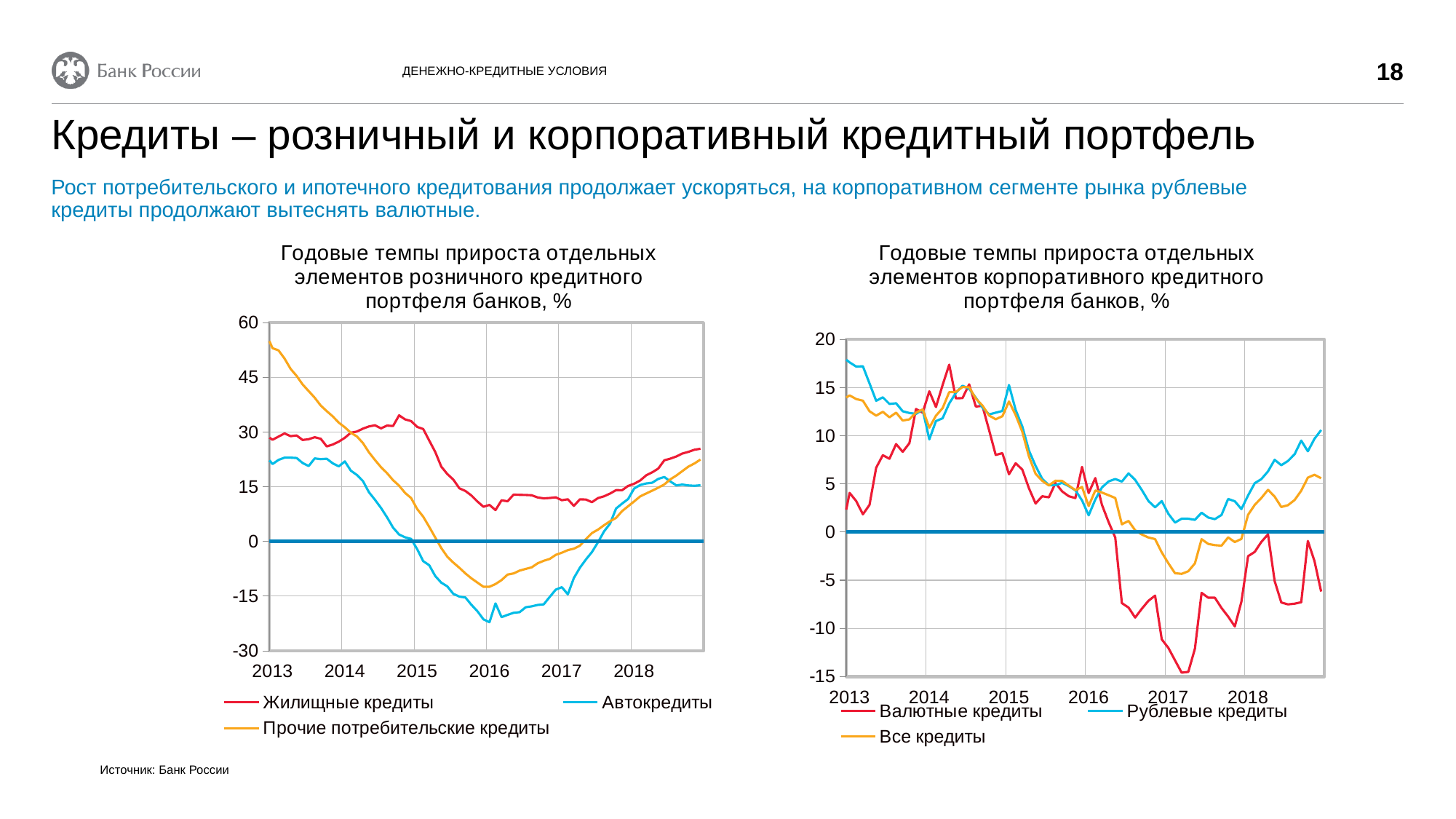
In the right chart (corporate loan portfolio), is the value for 'Рублевые кредиты' at the start of 2013 greater or less than 15? greater In the left chart (retail loan portfolio), is the value for 'Прочие потребительские кредиты' at the start of 2013 greater or less than 45? greater In the right chart (corporate loan portfolio), does the 'Рублевые кредиты' line rise or fall between 2017 and the end of 2018? rise In the right chart (corporate loan portfolio), which series has the higher value at the start of 2017: 'Валютные кредиты' or 'Рублевые кредиты'? Рублевые кредиты How many series does the legend of the left chart (retail loan portfolio) list? 3 How many series does the legend of the right chart, 'Годовые темпы прироста отдельных элементов корпоративного кредитного портфеля банков, %', list? 3 In the left chart (retail loan portfolio), which series has the higher value at the start of 2013: 'Жилищные кредиты' or 'Прочие потребительские кредиты'? Прочие потребительские кредиты In the left chart (retail loan portfolio), does the 'Прочие потребительские кредиты' line rise or fall between 2013 and 2016? fall What colour is the 'Валютные кредиты' line in the right chart (corporate loan portfolio)? red What kind of chart is the left chart, 'Годовые темпы прироста отдельных элементов розничного кредитного портфеля банков, %'? line chart In the right chart (corporate loan portfolio), is the value for 'Валютные кредиты' at the start of 2017 greater or less than -10? less